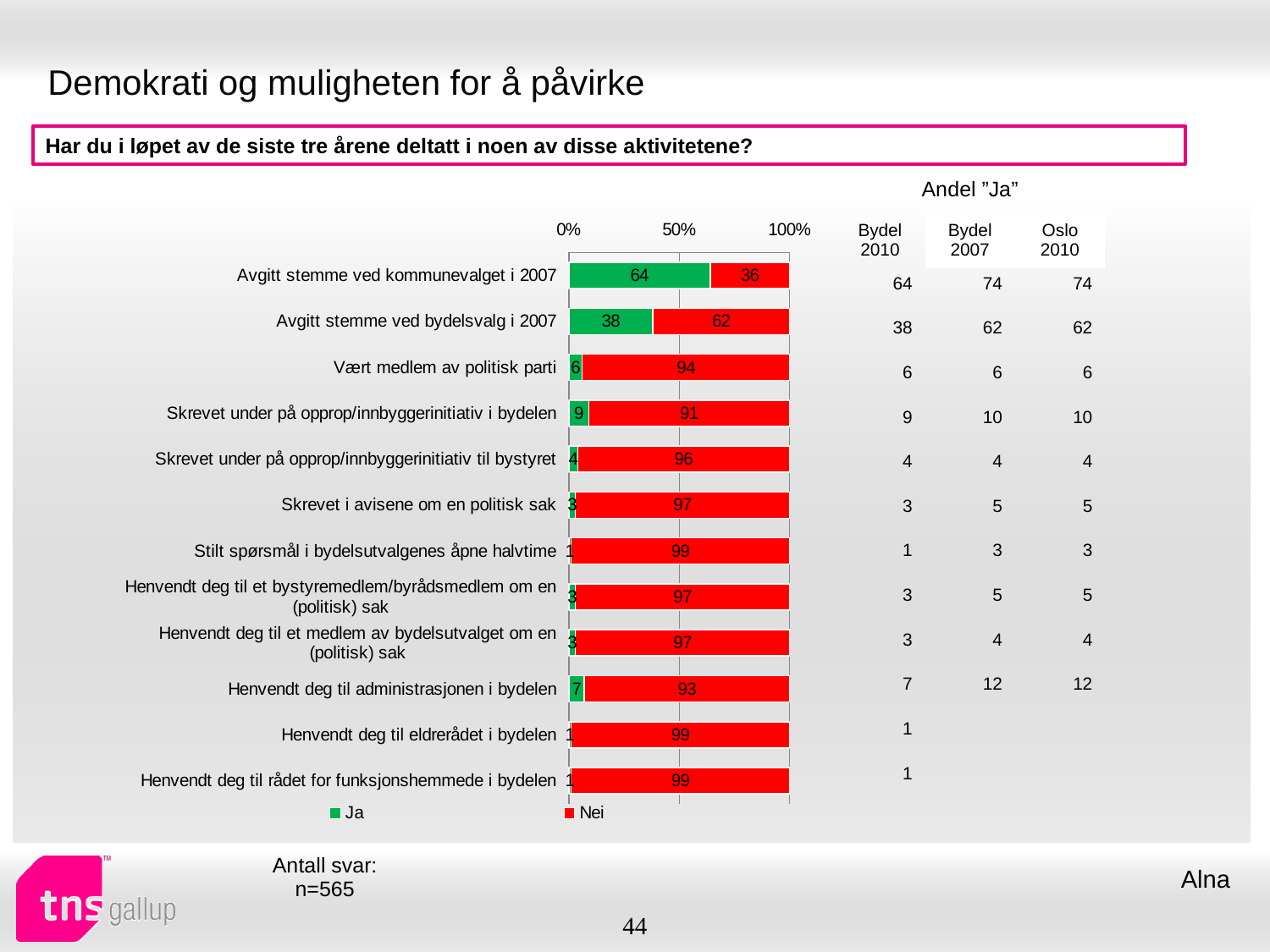
How many categories (activities) are plotted in the chart? 12 What is the 'Nei' value for 'Avgitt stemme ved bydelsvalg i 2007'? 62 What is the 'Ja' value for 'Avgitt stemme ved kommunevalget i 2007'? 64 Which category has the highest 'Ja' value? Avgitt stemme ved kommunevalget i 2007 Which colour represents the 'Nei' series in the chart? red What is the difference between the 'Ja' values for 'Avgitt stemme ved kommunevalget i 2007' and 'Avgitt stemme ved bydelsvalg i 2007'? 26 What is the 'Nei' value for 'Vært medlem av politisk parti'? 94 Which is larger: the 'Ja' value for 'Skrevet under på opprop/innbyggerinitiativ i bydelen' or for 'Henvendt deg til administrasjonen i bydelen'? Skrevet under på opprop/innbyggerinitiativ i bydelen What is the total of the stacked bar for 'Skrevet under på opprop/innbyggerinitiativ i bydelen'? 100 What kind of chart is shown on the slide? bar chart How many series does the chart legend list? 2 Is the 'Nei' value for 'Avgitt stemme ved kommunevalget i 2007' greater or less than 50%? less